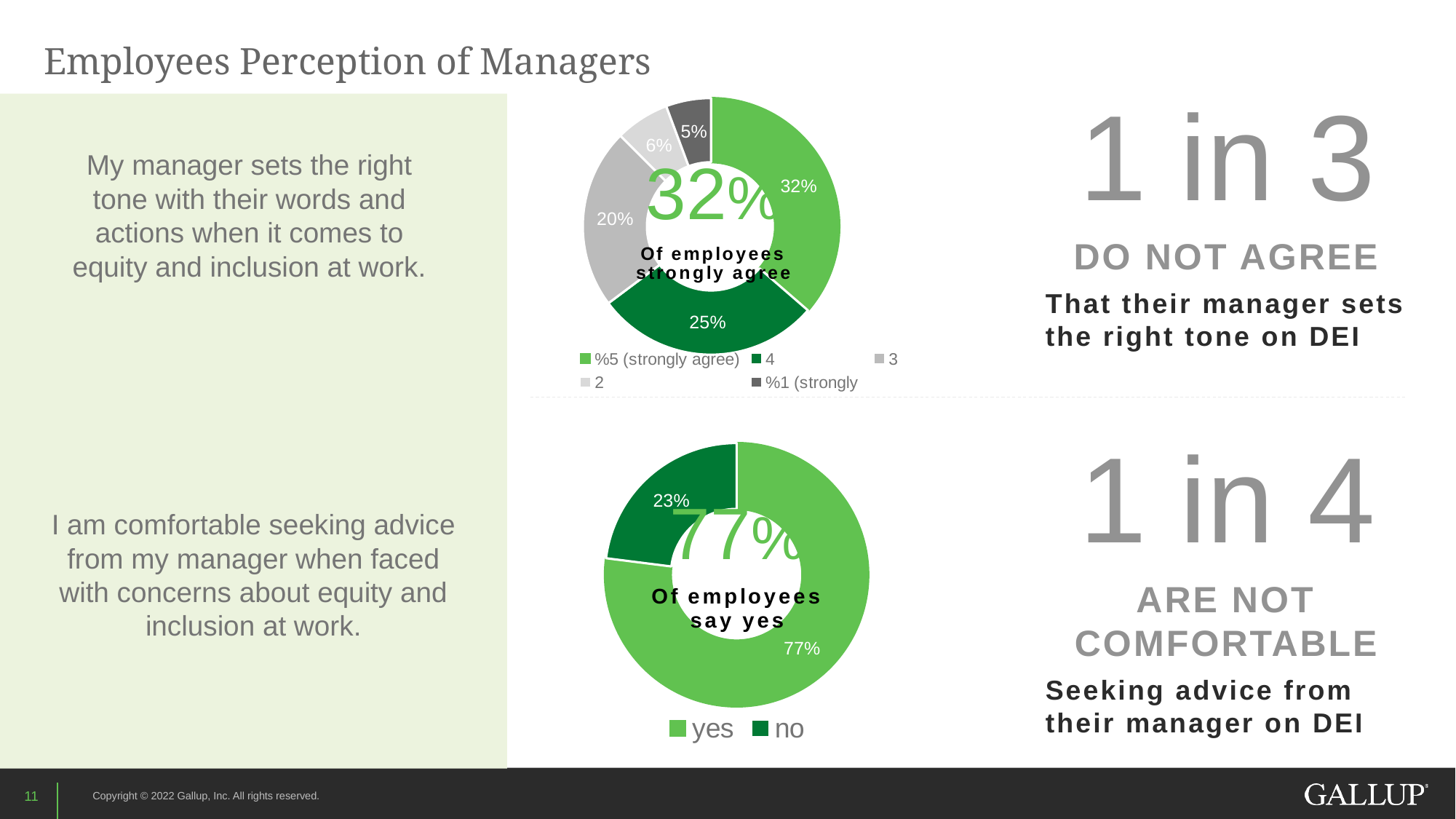
In the top chart, what percentage of employees gave a rating of 4? 25% In the top chart, what percentage of employees gave a rating of 3? 20% In the bottom chart, which is larger, the yes slice or the no slice? yes In the top chart, what percentage of employees gave a rating of 2? 6% In the bottom chart, what percentage of employees say yes to being comfortable seeking advice from their manager? 77% In the top chart, which rating category has the largest share? %5 (strongly agree) What type of chart is used for the bottom chart on the slide? Donut (pie) chart In the top chart, what is the difference in percentage points between the rating 5 slice and the rating 4 slice? 7 In the top chart, which rating category has the smallest share? %1 (strongly In the top chart, what percentage of employees strongly agree (rating 5) that their manager sets the right tone on equity and inclusion? 32% In the bottom chart, what percentage of employees say no? 23% How many slices does the top donut chart have? 5